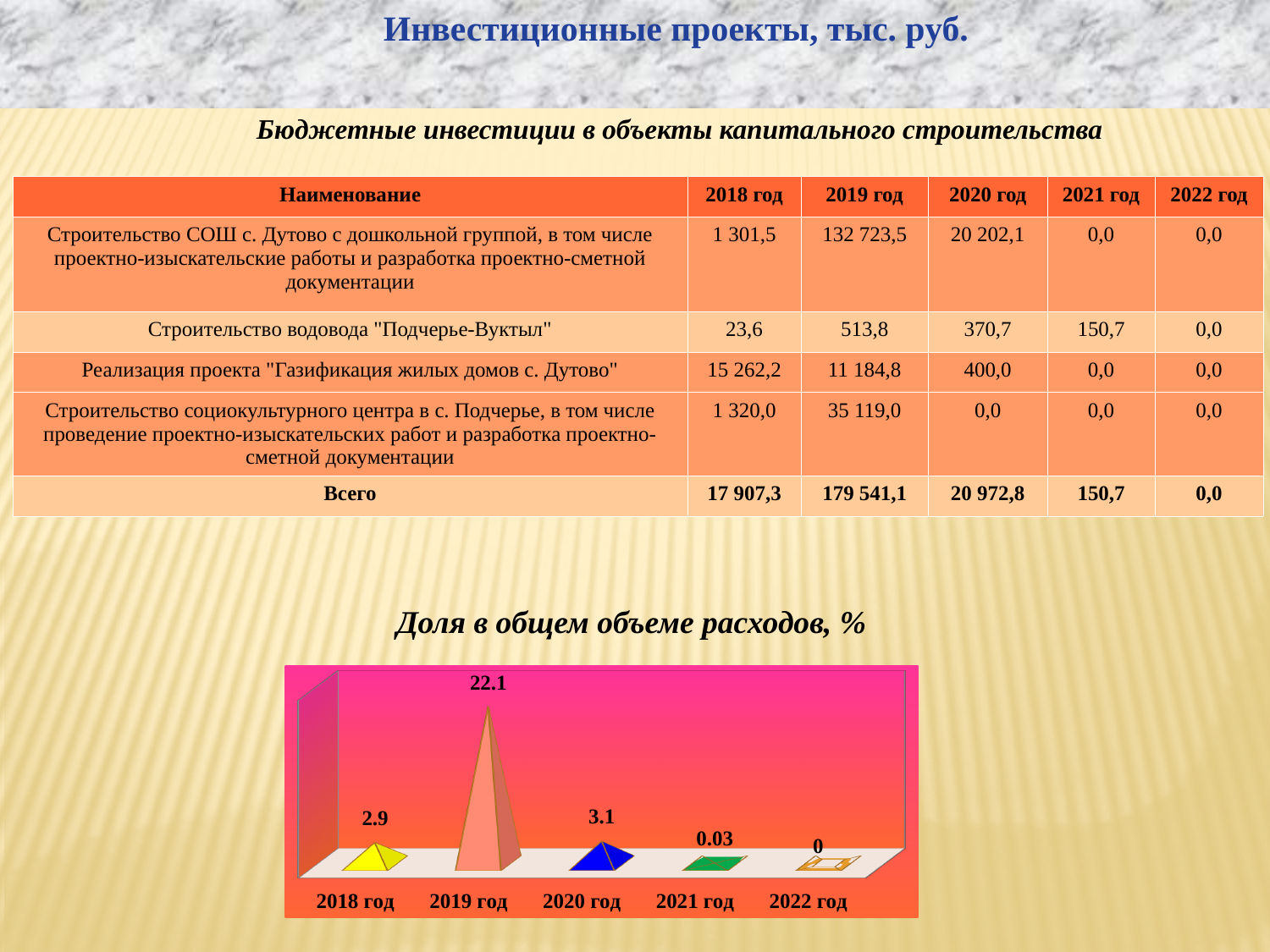
What is the value for 2021 год in the chart "Доля в общем объеме расходов, %"? 0.03 In the chart "Доля в общем объеме расходов, %", do the values rise or fall from 2019 год to 2022 год? fall What is the value for 2018 год in the chart "Доля в общем объеме расходов, %"? 2.9 What is the value for 2020 год in the chart "Доля в общем объеме расходов, %"? 3.1 Which year has the highest value in the chart "Доля в общем объеме расходов, %"? 2019 год In the chart "Доля в общем объеме расходов, %", what is the difference between the values for 2019 год and 2020 год? 19 How many years are shown on the x axis of the chart "Доля в общем объеме расходов, %"? 5 What kind of chart is "Доля в общем объеме расходов, %"? bar chart Which year has the lowest value in the chart "Доля в общем объеме расходов, %"? 2022 год In the chart "Доля в общем объеме расходов, %", which is larger: the value for 2018 год or 2020 год? 2020 год What is the value for 2022 год in the chart "Доля в общем объеме расходов, %"? 0 What is the value for 2019 год in the chart "Доля в общем объеме расходов, %"? 22.1